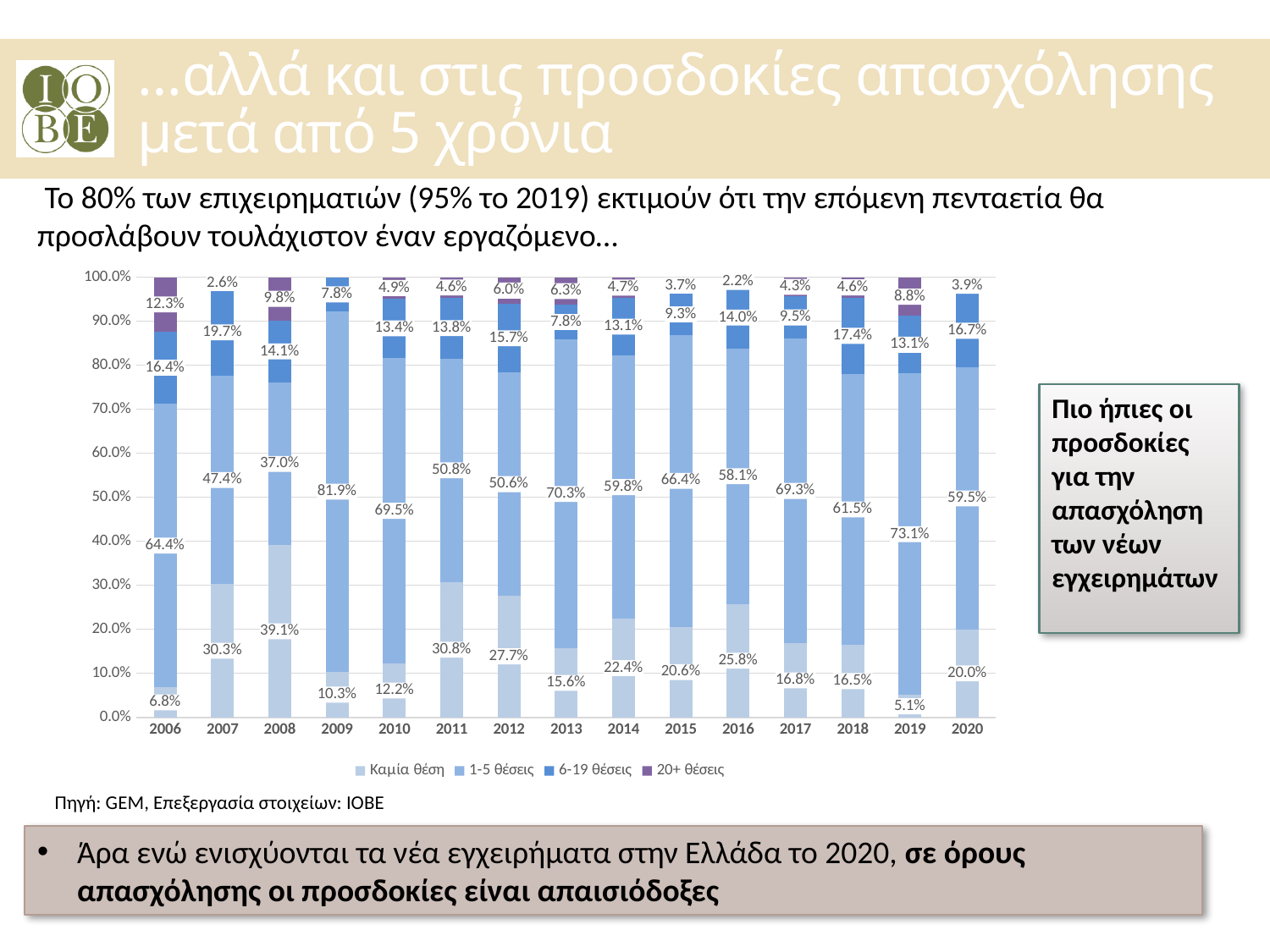
What is the difference between the '1-5 θέσεις' values in 2019 and 2020? 13.6% What is the value for '1-5 θέσεις' in 2009? 81.9% In which year is the 'Καμία θέση' share the lowest? 2019 What is the value for '6-19 θέσεις' in 2018? 17.4% What is the value for '20+ θέσεις' in 2006? 12.3% What kind of chart is shown on the slide? Stacked bar chart What is the value for 'Καμία θέση' in 2020? 20.0% How many years are shown on the x axis of the chart? 15 Which is larger: the 'Καμία θέση' value in 2008 or in 2011? 2008 In which year is the '1-5 θέσεις' share the highest? 2009 Which series is shown in the darkest purple colour in the legend? 20+ θέσεις How many series does the legend list? 4